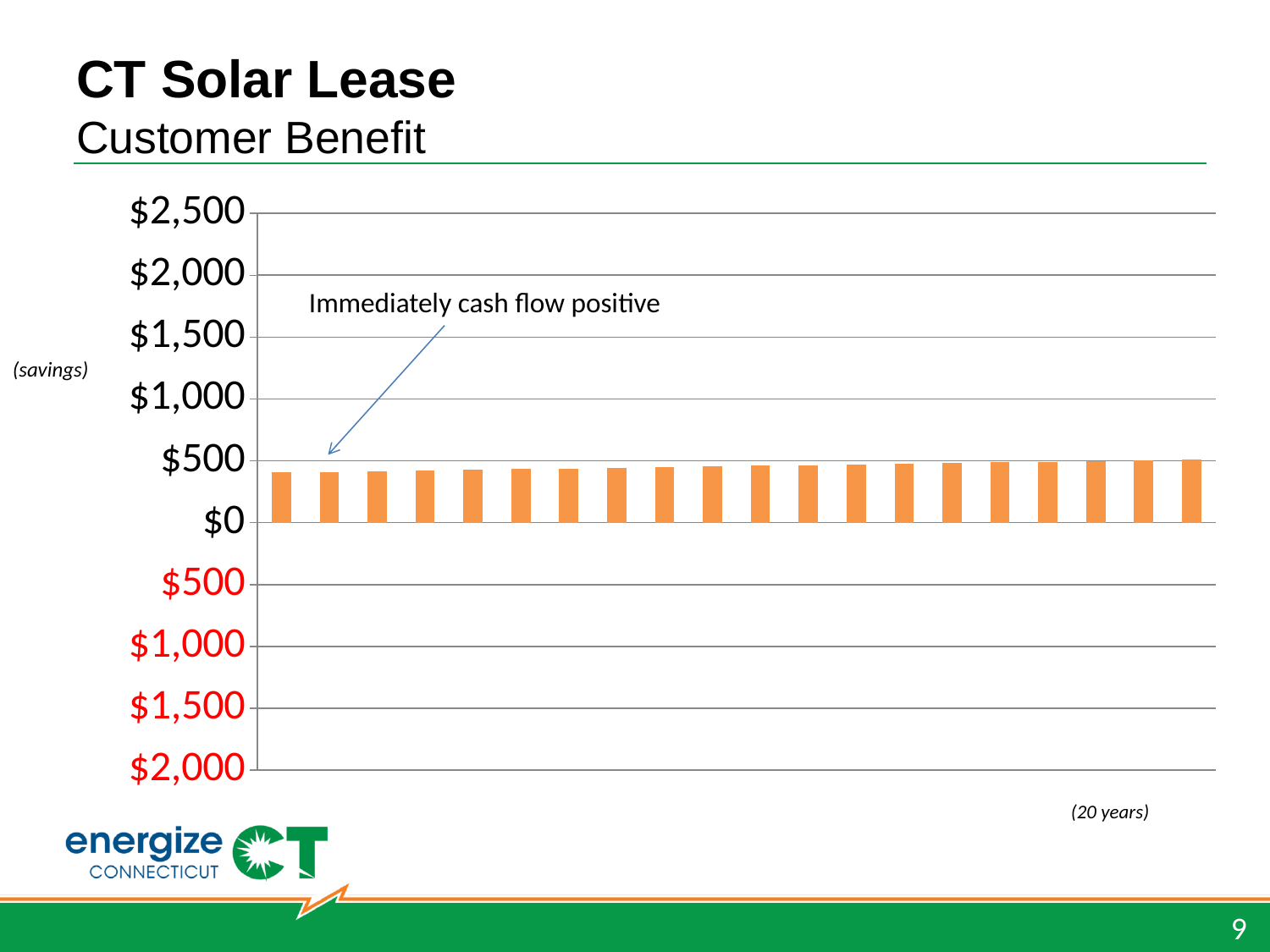
Is the value of the last bar greater or less than $0? greater Are any of the bars below $0 (negative)? No Is the value of the first bar greater or less than $500? less What text does the annotation with the arrow in the chart say? Immediately cash flow positive What is the highest value shown on the y axis? $2,500 What kind of chart is shown on the slide? bar chart How many bars are plotted in the chart? 20 Do the bar values rise or fall from left to right across the chart? rise